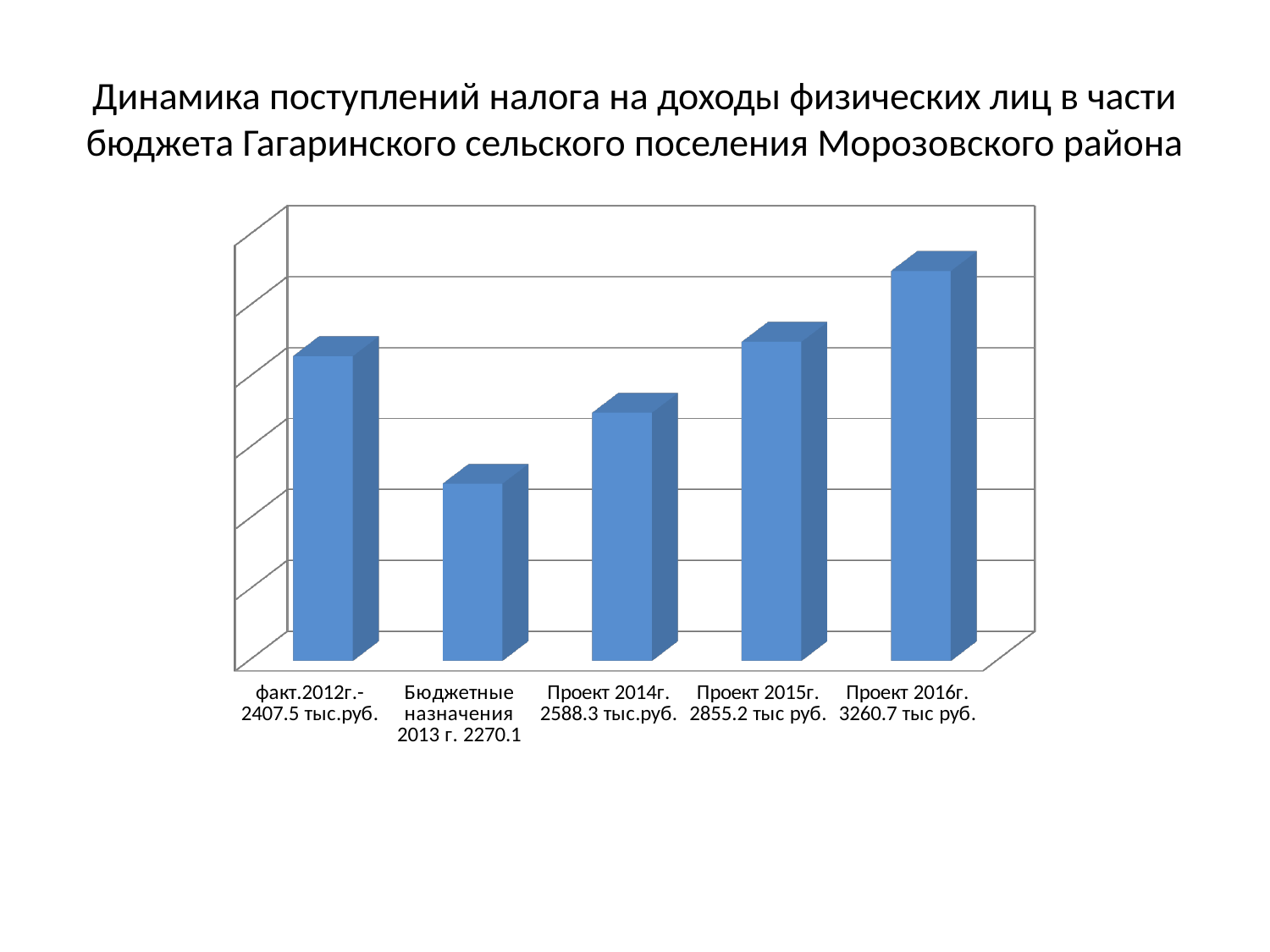
From Бюджетные назначения 2013 г. to Проект 2016г., do the values rise or fall? Rise What colour are the bars in the chart? Blue What is the difference between the values for Проект 2016г. and Проект 2015г.? 405.5 How many bars are shown in the chart? 5 Which category has the lowest bar? Бюджетные назначения 2013 г. What value is shown for Проект 2014г.? 2588.3 тыс.руб. What value is shown for Бюджетные назначения 2013 г.? 2270.1 Which category has the highest bar? Проект 2016г. What value is shown for Проект 2016г.? 3260.7 тыс руб. What is the difference between the values for факт.2012г. and Бюджетные назначения 2013 г.? 137.4 What kind of chart is shown on the slide? Bar chart